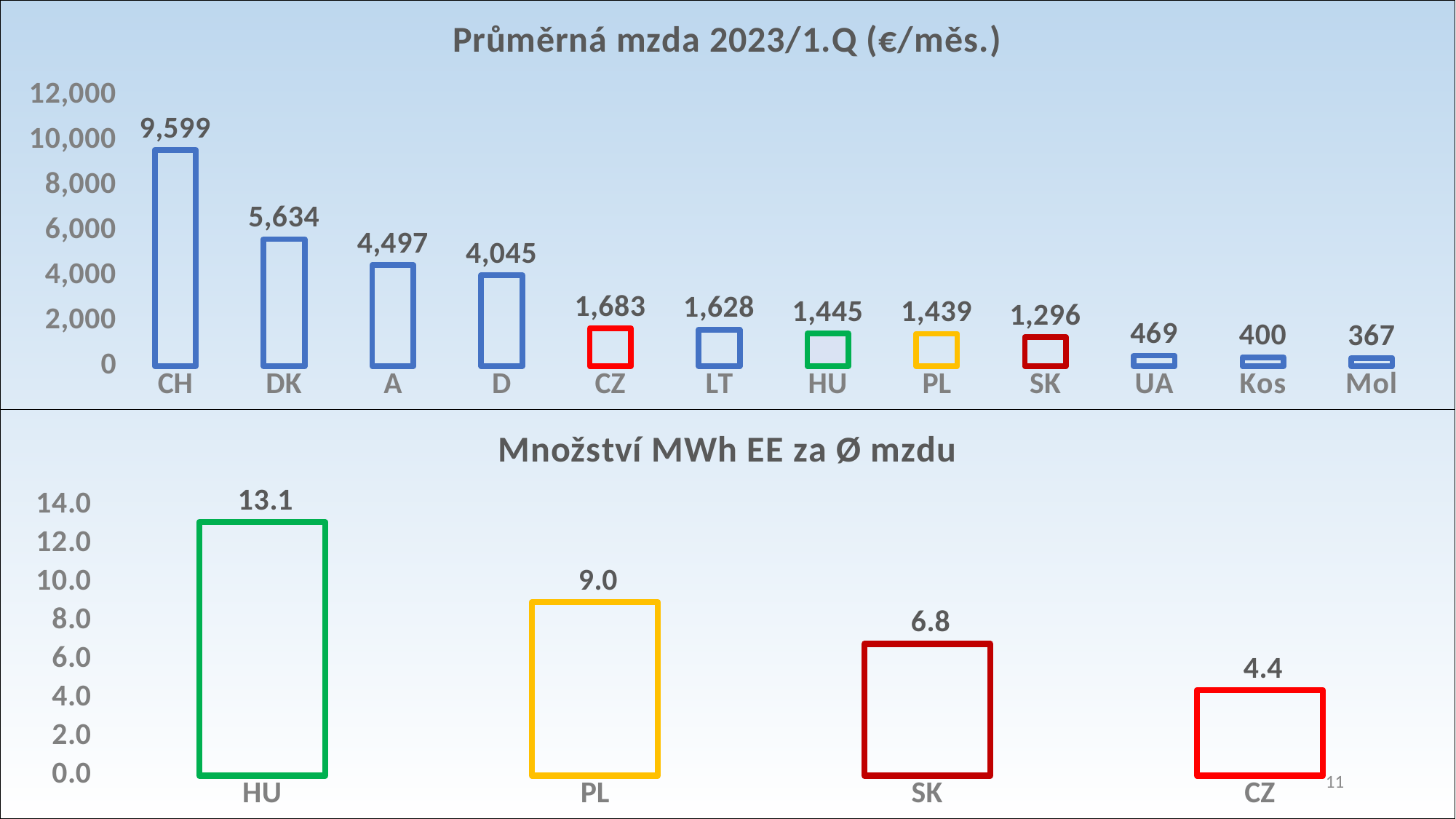
In the chart 'Průměrná mzda 2023/1.Q (€/měs.)', what is the difference between the values for DK and A? 1,137 What kind of chart is the bottom chart 'Množství MWh EE za Ø mzdu'? bar chart In the chart 'Průměrná mzda 2023/1.Q (€/měs.)', which category has the lowest value? Mol In the chart 'Průměrná mzda 2023/1.Q (€/měs.)', which is larger, the value for UA or the value for Kos? UA In the chart 'Množství MWh EE za Ø mzdu', which category has the highest value? HU In the chart 'Průměrná mzda 2023/1.Q (€/měs.)', how many categories are shown? 12 In the chart 'Množství MWh EE za Ø mzdu', what is the value for PL? 9.0 In the chart 'Průměrná mzda 2023/1.Q (€/měs.)', what is the value for CH? 9,599 In the chart 'Množství MWh EE za Ø mzdu', do the values rise or fall from left to right along the x axis? fall In the chart 'Množství MWh EE za Ø mzdu', what is the difference between the values for HU and CZ? 8.7 In the chart 'Průměrná mzda 2023/1.Q (€/měs.)', which category has the highest value? CH In the chart 'Průměrná mzda 2023/1.Q (€/měs.)', what is the value for CZ? 1,683